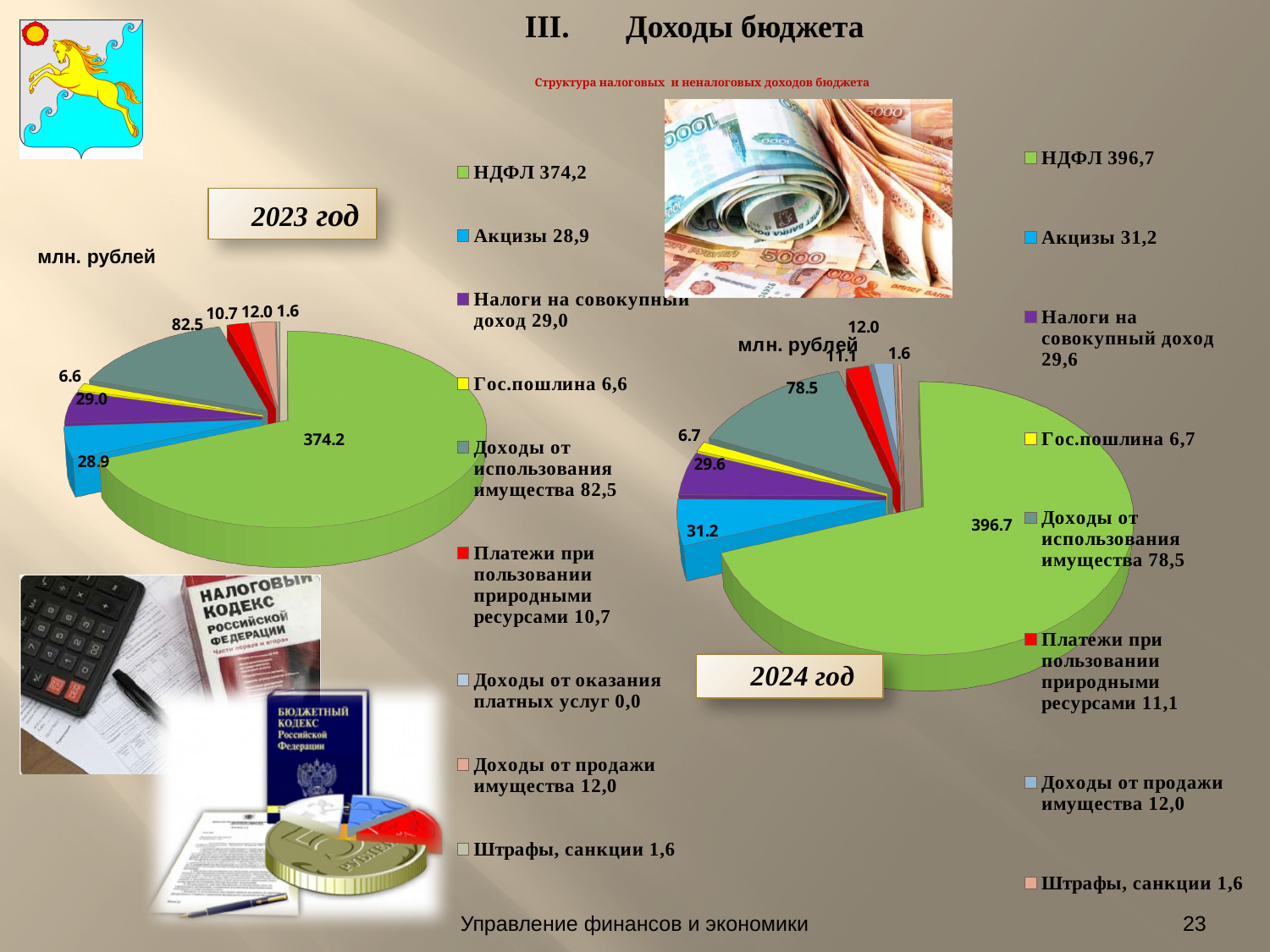
In the 2023 год chart, what is the value for НДФЛ? 374,2 In the 2024 год chart, what is the value for Акцизы? 31,2 What kind of chart is used for the 2023 год data? pie chart In the 2023 год chart, what is the difference between Налоги на совокупный доход and Акцизы? 0,1 How many categories does the legend of the 2024 год chart list? 8 In the 2024 год chart, which category has the largest value? НДФЛ How much larger is НДФЛ in the 2024 год chart than in the 2023 год chart? 22,5 In the 2023 год chart, which category has the smallest value? Доходы от оказания платных услуг In the 2024 год chart, what is the value for Платежи при пользовании природными ресурсами? 11,1 Is Доходы от использования имущества larger in the 2023 год chart or the 2024 год chart? 2023 год In the 2024 год chart, what colour is the НДФЛ slice? green How many categories does the legend of the 2023 год chart list? 9